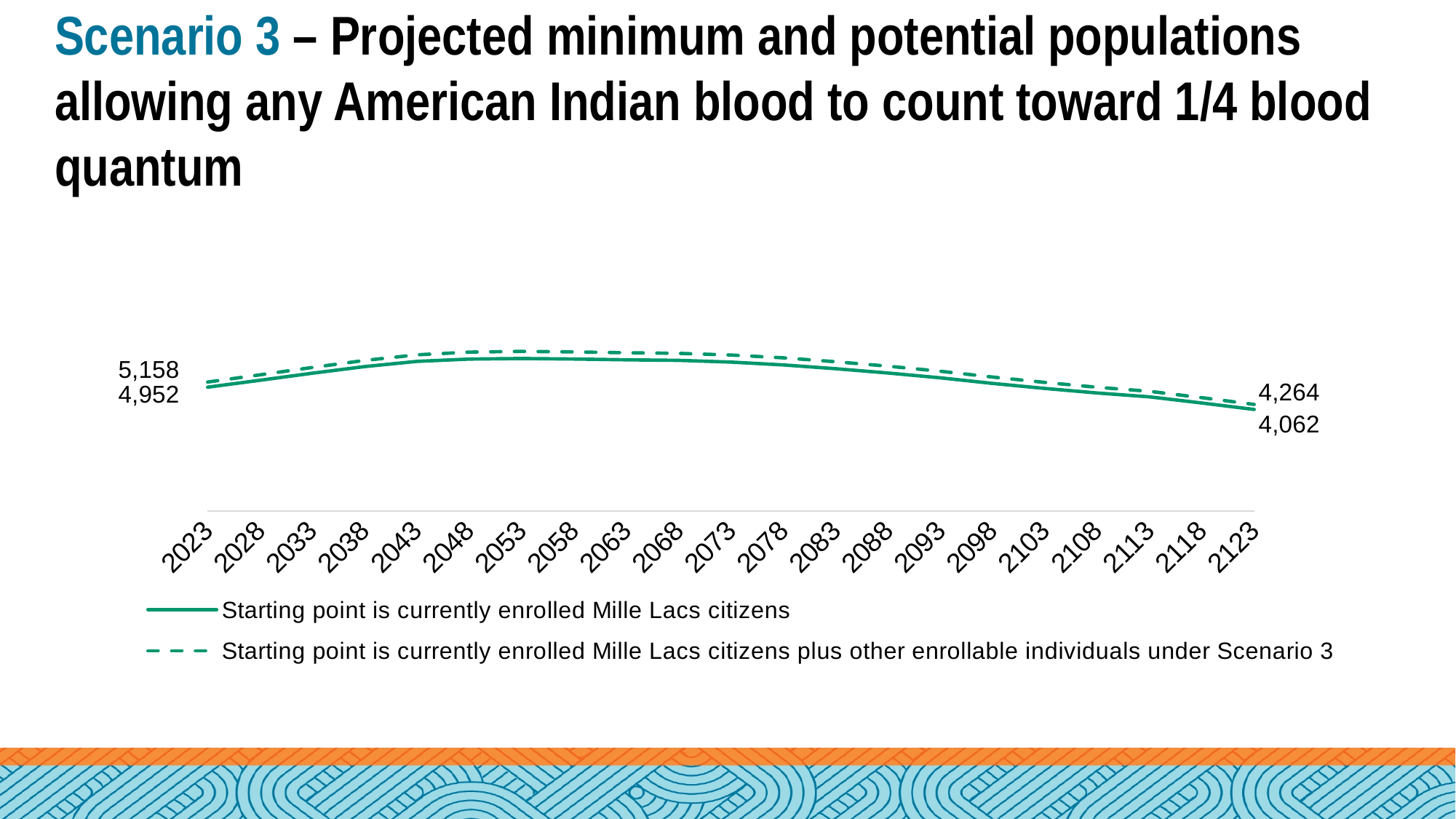
What is the difference between the two series' values in 2023? 206 What is the 2023 value for the series 'Starting point is currently enrolled Mille Lacs citizens'? 4,952 Which line style is used for the series 'Starting point is currently enrolled Mille Lacs citizens plus other enrollable individuals under Scenario 3'? Dashed How many years are labelled along the x axis? 21 What is the difference between the two series' values in 2123? 202 What is the 2123 value for the series 'Starting point is currently enrolled Mille Lacs citizens'? 4,062 What type of chart is shown on the slide? Line chart Which series has the higher value in 2123? Starting point is currently enrolled Mille Lacs citizens plus other enrollable individuals under Scenario 3 For the solid-line series, how much does the value fall from 2023 to 2123? 890 What is the 2023 value for the series 'Starting point is currently enrolled Mille Lacs citizens plus other enrollable individuals under Scenario 3'? 5,158 How many series does the legend list? 2 What is the 2123 value for the series 'Starting point is currently enrolled Mille Lacs citizens plus other enrollable individuals under Scenario 3'? 4,264